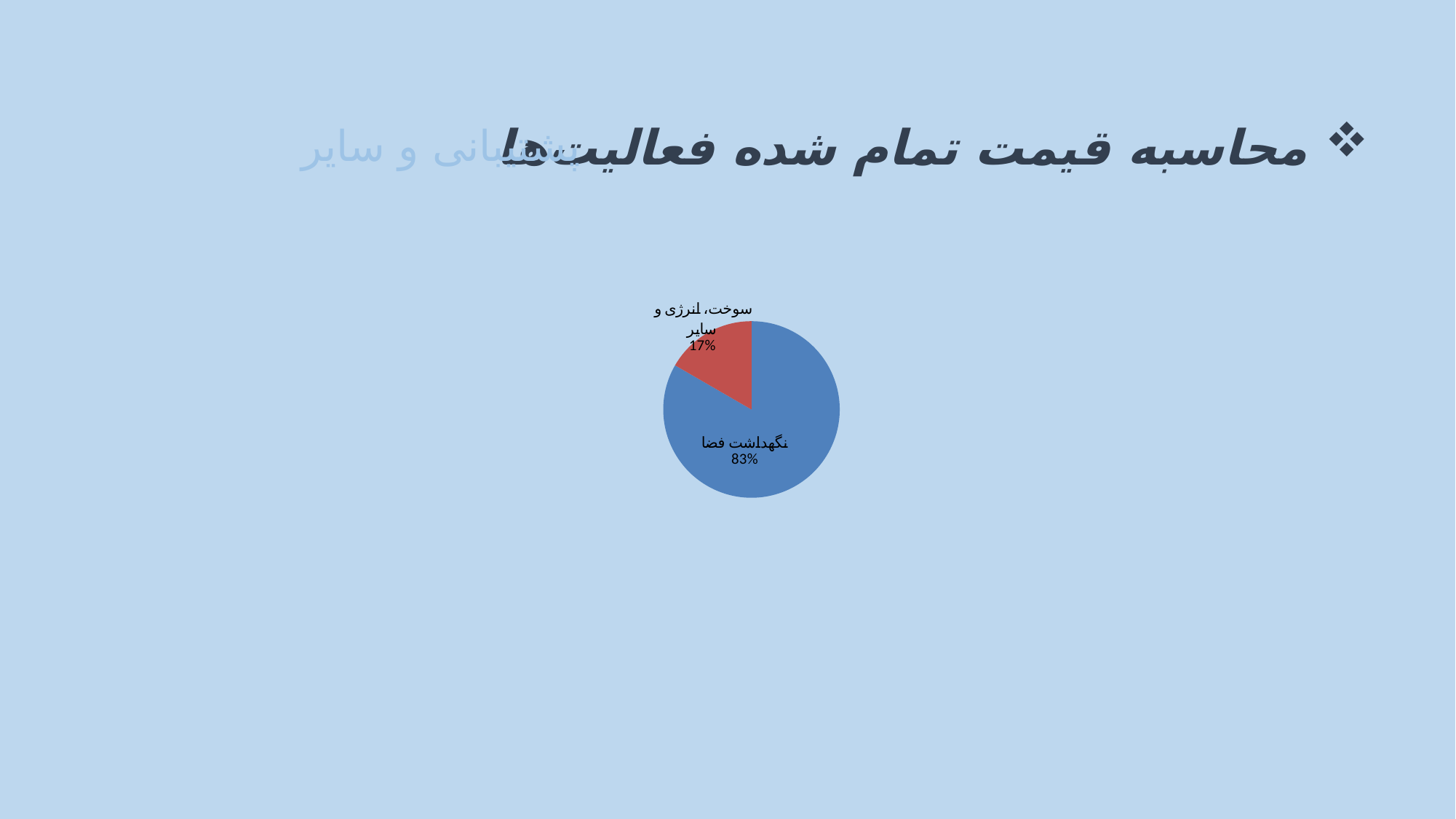
What share of the pie does the slice labelled نگهداشت فضا represent? 83% What is the difference in percentage points between the نگهداشت فضا slice and the سوخت، انرژی و سایر slice? 66 What colour is the slice labelled سوخت، انرژی و سایر? red What colour is the slice labelled نگهداشت فضا? blue How many slices does the pie chart have? 2 What share of the pie does the slice labelled سوخت، انرژی و سایر represent? 17% Which slice of the pie chart is the smallest? سوخت، انرژی و سایر Which slice of the pie chart is the largest? نگهداشت فضا Which is larger: the share for نگهداشت فضا or the share for سوخت، انرژی و سایر? نگهداشت فضا What kind of chart is shown on the slide? pie chart